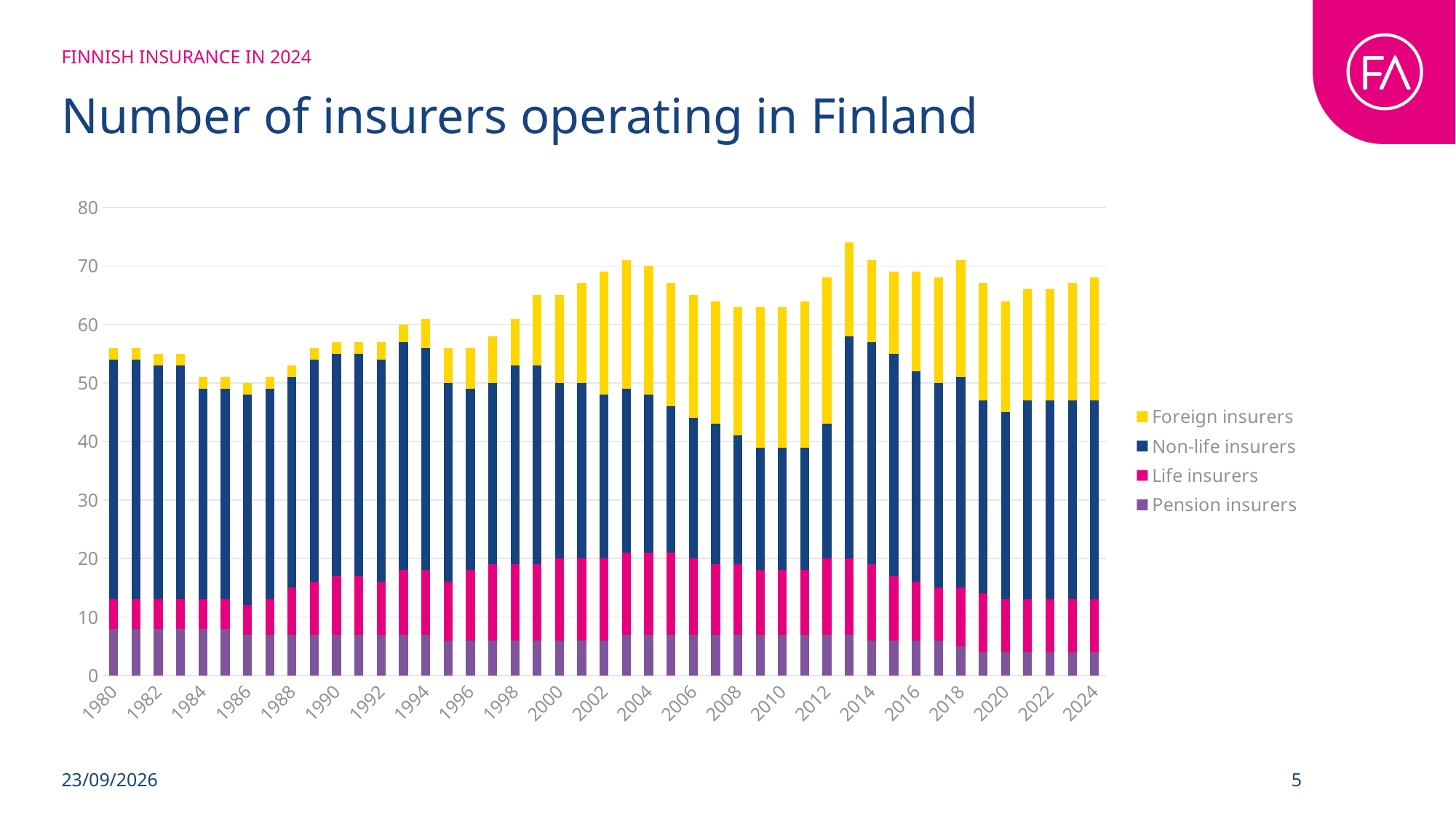
Is the number of foreign insurers in 1980 greater or less than 10? less Is the total number of insurers in 1986 greater or less than 60? less Which year has the highest total number of insurers? 2013 Is the total number of insurers in 2024 greater or less than 60? greater Does the number of foreign insurers rise or fall between 1980 and 2024? Rise What is the title of the chart? Number of insurers operating in Finland Which year has a larger total number of insurers, 1980 or 2013? 2013 How many series does the legend list? 4 How many years (bars) are plotted in the chart? 45 What kind of chart is shown on the slide? Stacked bar chart Which series is shown at the bottom of each stacked bar? Pension insurers